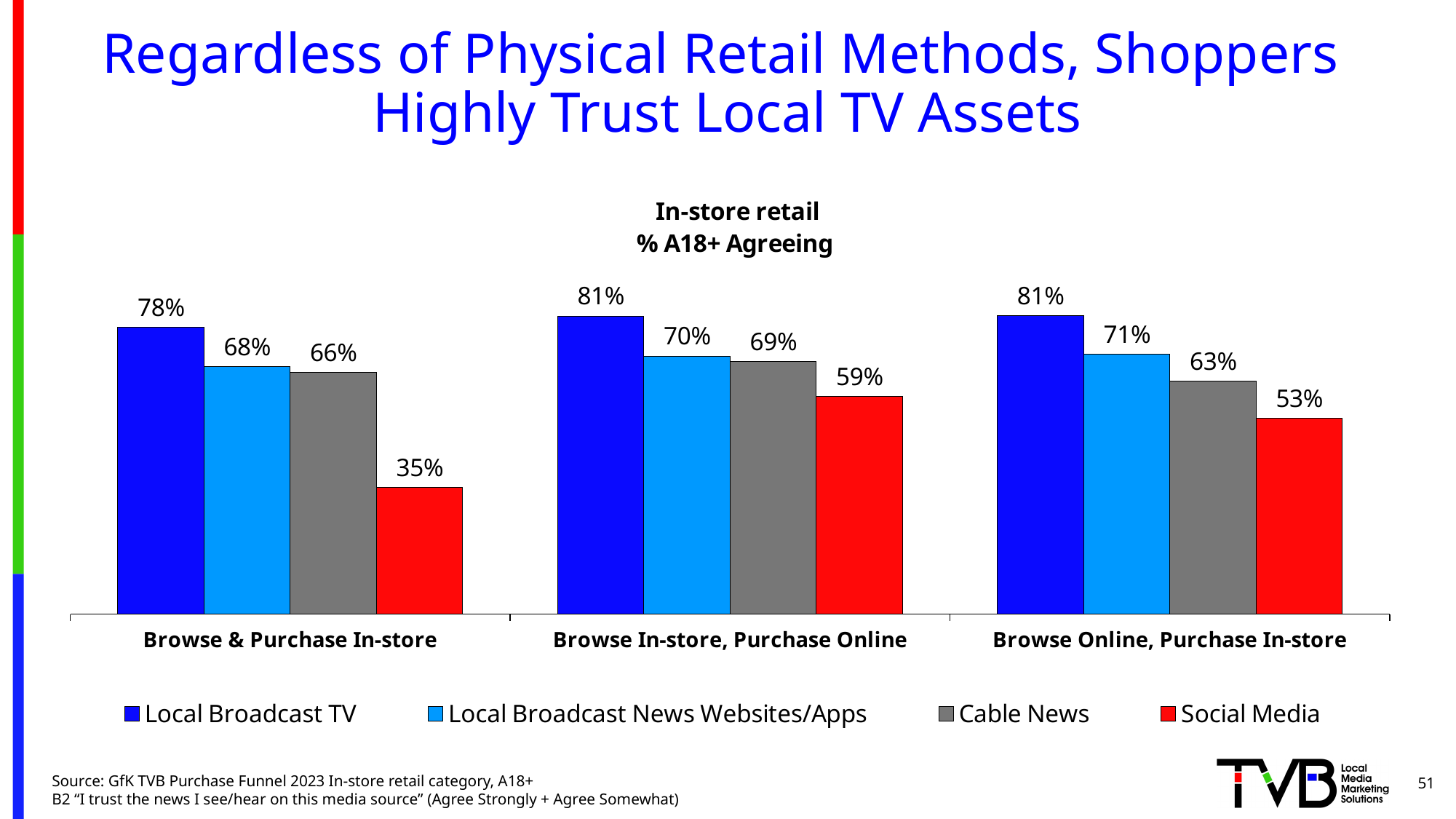
Which series has the lowest value in the Browse & Purchase In-store category? Social Media What is the value for Local Broadcast TV in the Browse & Purchase In-store category? 78% Which series has the highest value in the Browse In-store, Purchase Online category? Local Broadcast TV How many categories are shown on the x axis? 3 What is the title of the chart? In-store retail % A18+ Agreeing How many series does the legend list? 4 Which colour represents Social Media in the chart? Red What is the value for Social Media in the Browse In-store, Purchase Online category? 59% What kind of chart is shown on the slide? Bar chart Which is larger: Local Broadcast News Websites/Apps in Browse Online, Purchase In-store or Cable News in Browse In-store, Purchase Online? Local Broadcast News Websites/Apps in Browse Online, Purchase In-store What is the value for Cable News in the Browse Online, Purchase In-store category? 63% What is the difference between Local Broadcast TV and Social Media in the Browse & Purchase In-store category? 43 percentage points